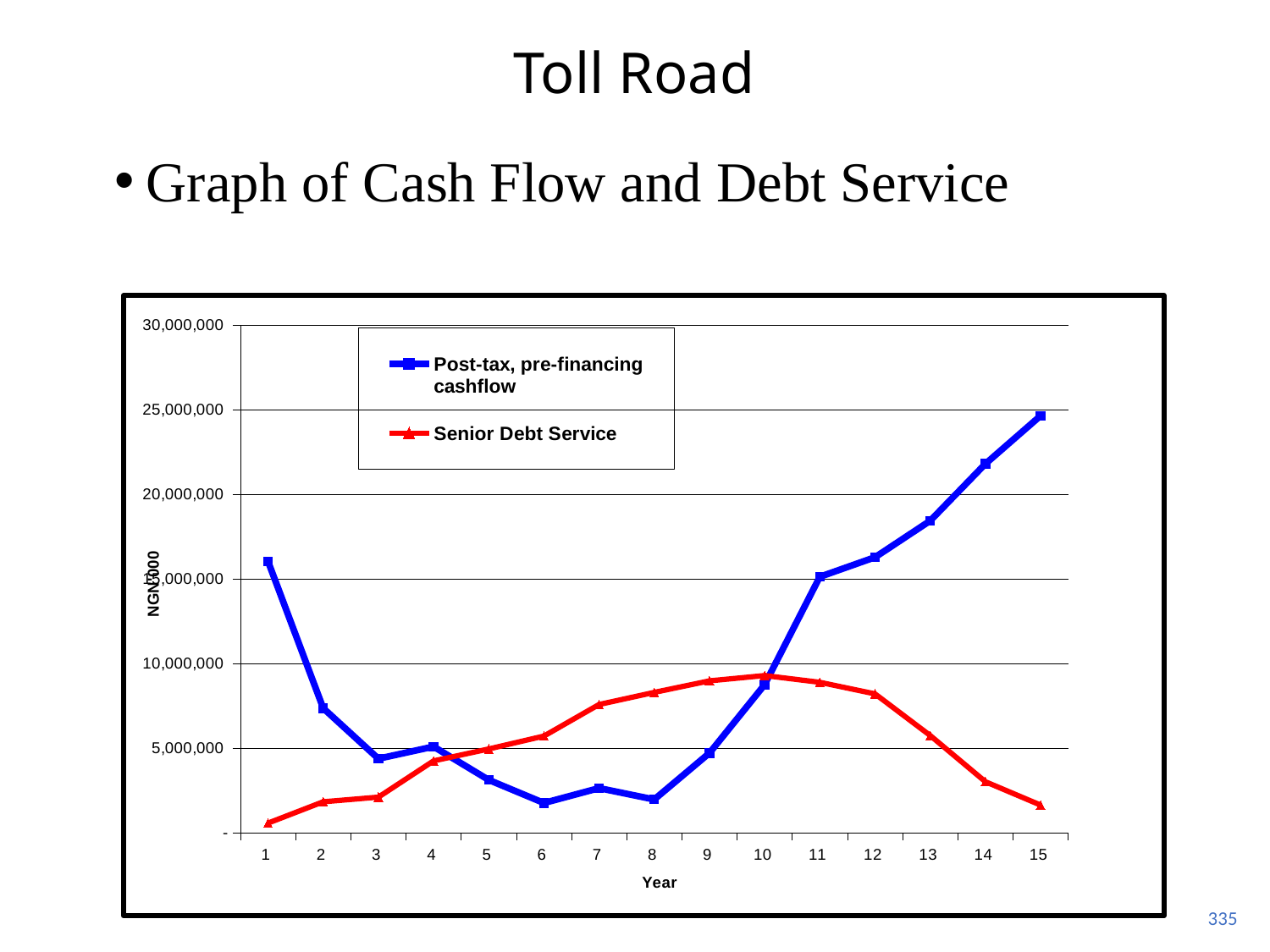
In which year is the Post-tax, pre-financing cashflow highest? 15 In year 13, which is larger: the Post-tax, pre-financing cashflow or the Senior Debt Service? Post-tax, pre-financing cashflow How many series does the legend list? 2 How many years are plotted along the x axis? 15 What is the label on the y axis? NGN'000 What kind of chart is shown on the slide? line chart Is the Senior Debt Service in year 10 greater or less than 10,000,000? less Is the Post-tax, pre-financing cashflow in year 15 greater or less than 20,000,000? greater In year 8, which is larger: the Post-tax, pre-financing cashflow or the Senior Debt Service? Senior Debt Service Does the Senior Debt Service rise or fall from year 10 to year 15? fall In which year is the Senior Debt Service lowest? 1 Is the Senior Debt Service in year 8 greater or less than 5,000,000? greater